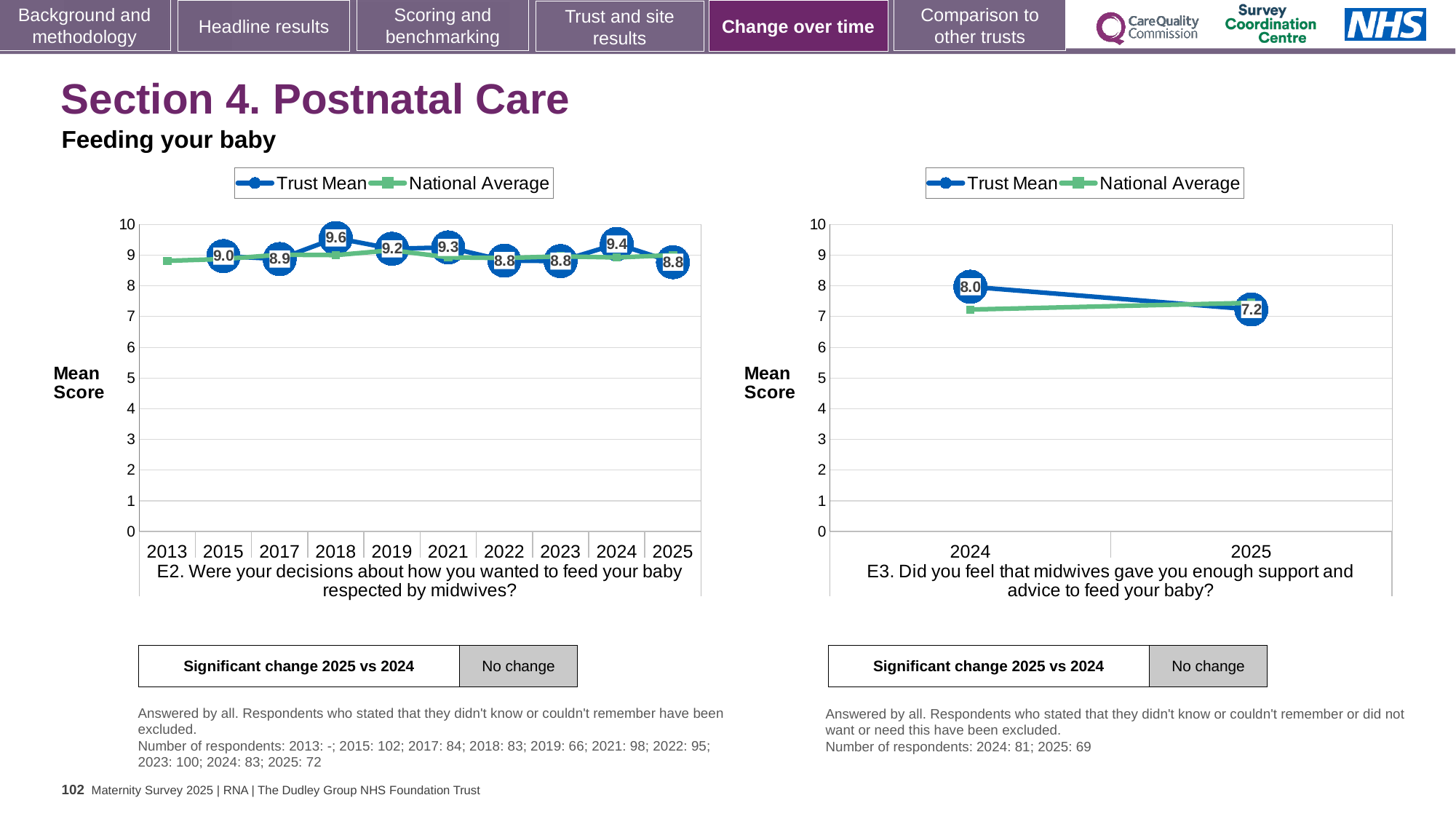
In the E2 chart on the left, which year has the highest Trust Mean? 2018 How many series does the legend of the E3 chart on the right list? 2 In the E3 chart on the right, what is the difference between the Trust Mean for 2024 and 2025? 0.8 What is the label on the y axis of the E2 chart on the left? Mean Score In the E3 chart on the right, what is the Trust Mean for 2024? 8.0 In the E2 chart on the left, what is the Trust Mean for 2025? 8.8 In the E2 chart on the left, what is the Trust Mean for 2018? 9.6 In the E3 chart on the right, does the Trust Mean rise or fall from 2024 to 2025? fall What kind of chart is the E2 chart on the left? line chart In the E3 chart on the right, is the National Average for 2024 greater or less than 8? less In the E2 chart on the left, which is larger, the Trust Mean for 2021 or for 2022? 2021 How many years are shown on the x axis of the E2 chart on the left? 10